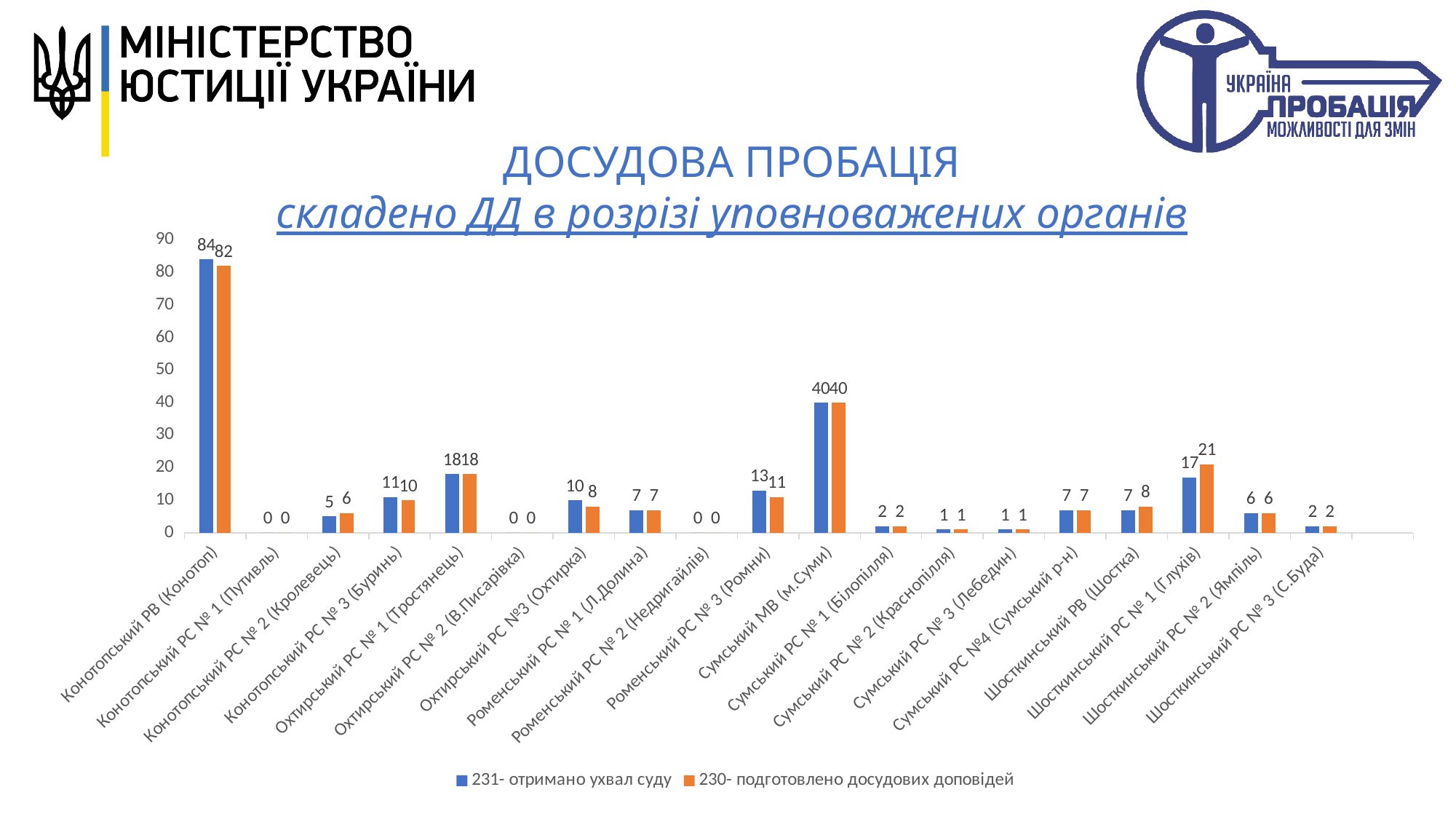
What is the value of '230- подготовлено досудових доповідей' for Шосткинський РС № 1 (Глухів)? 21 What is the value of '231- отримано ухвал суду' for Роменський РС № 3 (Ромни)? 13 Which is larger for Охтирський РС №3 (Охтирка): '231- отримано ухвал суду' or '230- подготовлено досудових доповідей'? 231- отримано ухвал суду How many categories (authorised bodies) are shown on the x axis? 19 How many series does the legend list? 2 What is the value of '231- отримано ухвал суду' for Конотопський РВ (Конотоп)? 84 Which category has the highest value for '231- отримано ухвал суду'? Конотопський РВ (Конотоп) What is the difference between '231- отримано ухвал суду' and '230- подготовлено досудових доповідей' for Конотопський РВ (Конотоп)? 2 What type of chart is shown on the slide? bar chart What colour are the bars for '230- подготовлено досудових доповідей'? orange Is the value of '231- отримано ухвал суду' for Сумський МВ (м.Суми) greater or less than 30? greater What is the difference between the two series for Шосткинський РС № 1 (Глухів)? 4